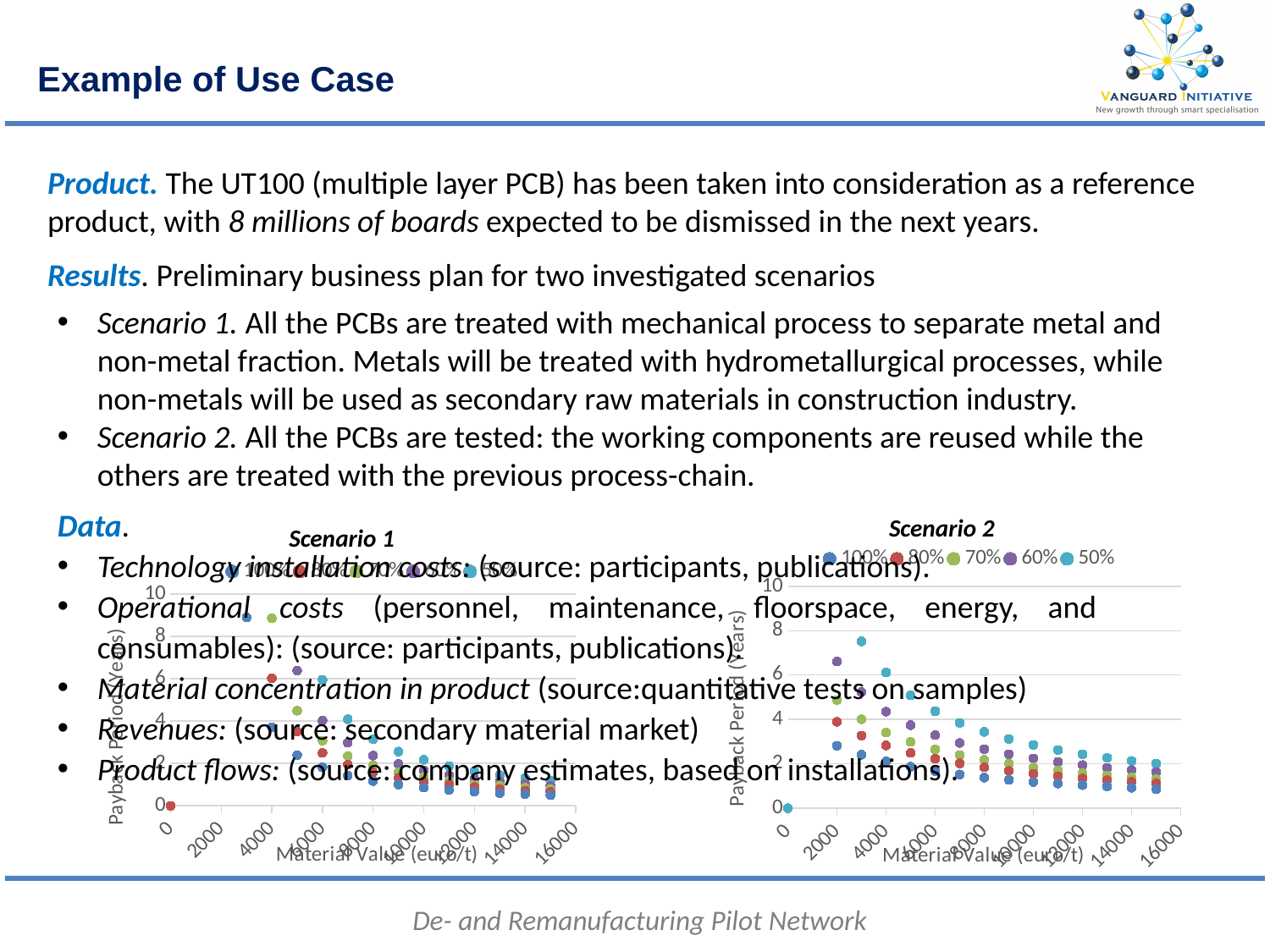
In the Scenario 1 chart, does the payback period rise or fall as material value increases? fall In the Scenario 2 chart, does the payback period rise or fall as material value increases? fall What are the legend entries of the Scenario 2 chart? 100%, 80%, 70%, 60%, 50% In the Scenario 2 chart, is the payback period for the 100% series at a material value of 14000 greater or less than 2? less What kind of chart is the Scenario 2 chart? scatter chart How many series does the legend of the Scenario 2 chart list? 5 What kind of chart is the Scenario 1 chart? scatter chart In the Scenario 2 chart, at a material value of 2000, which series has the higher payback period, 100% or 60%? 60% What is the y-axis label of the Scenario 2 chart? Payback Period (Years)